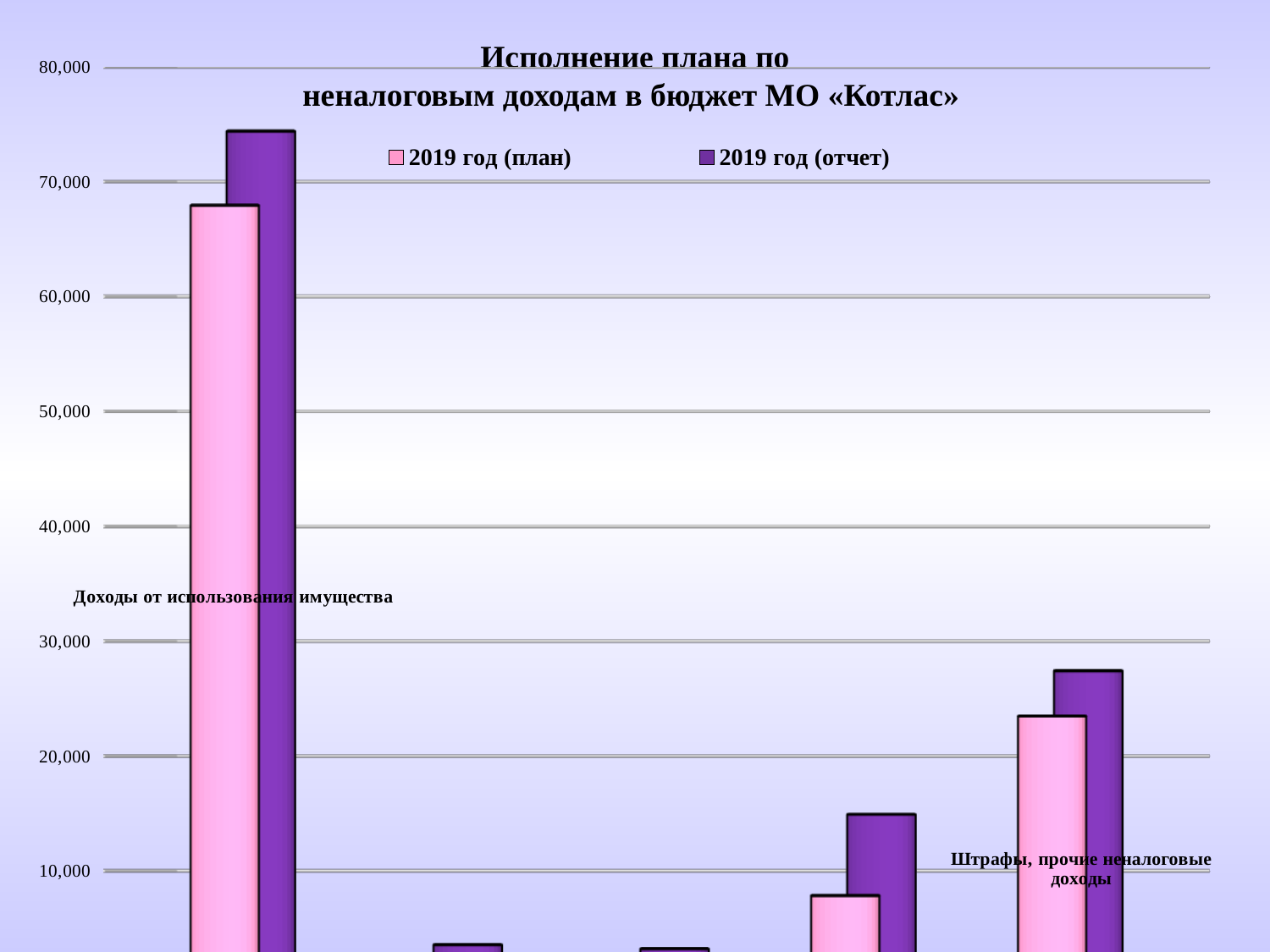
Is the 2019 год (план) value for Доходы от использования имущества greater or less than 60,000? greater What are the two series named in the legend? 2019 год (план) and 2019 год (отчет) Is the 2019 год (план) value for Штрафы, прочие неналоговые доходы greater or less than 20,000? greater Is the 2019 год (план) value for Доходы от использования имущества greater or less than 70,000? less What kind of chart is shown on the slide? bar chart How many series does the legend list? 2 For Доходы от использования имущества, which is larger: the 2019 год (план) value or the 2019 год (отчет) value? 2019 год (отчет) For Штрафы, прочие неналоговые доходы, which is larger: the 2019 год (план) value or the 2019 год (отчет) value? 2019 год (отчет) Which category has the highest 2019 год (отчет) value? Доходы от использования имущества What is the title of the chart? Исполнение плана по неналоговым доходам в бюджет МО «Котлас»